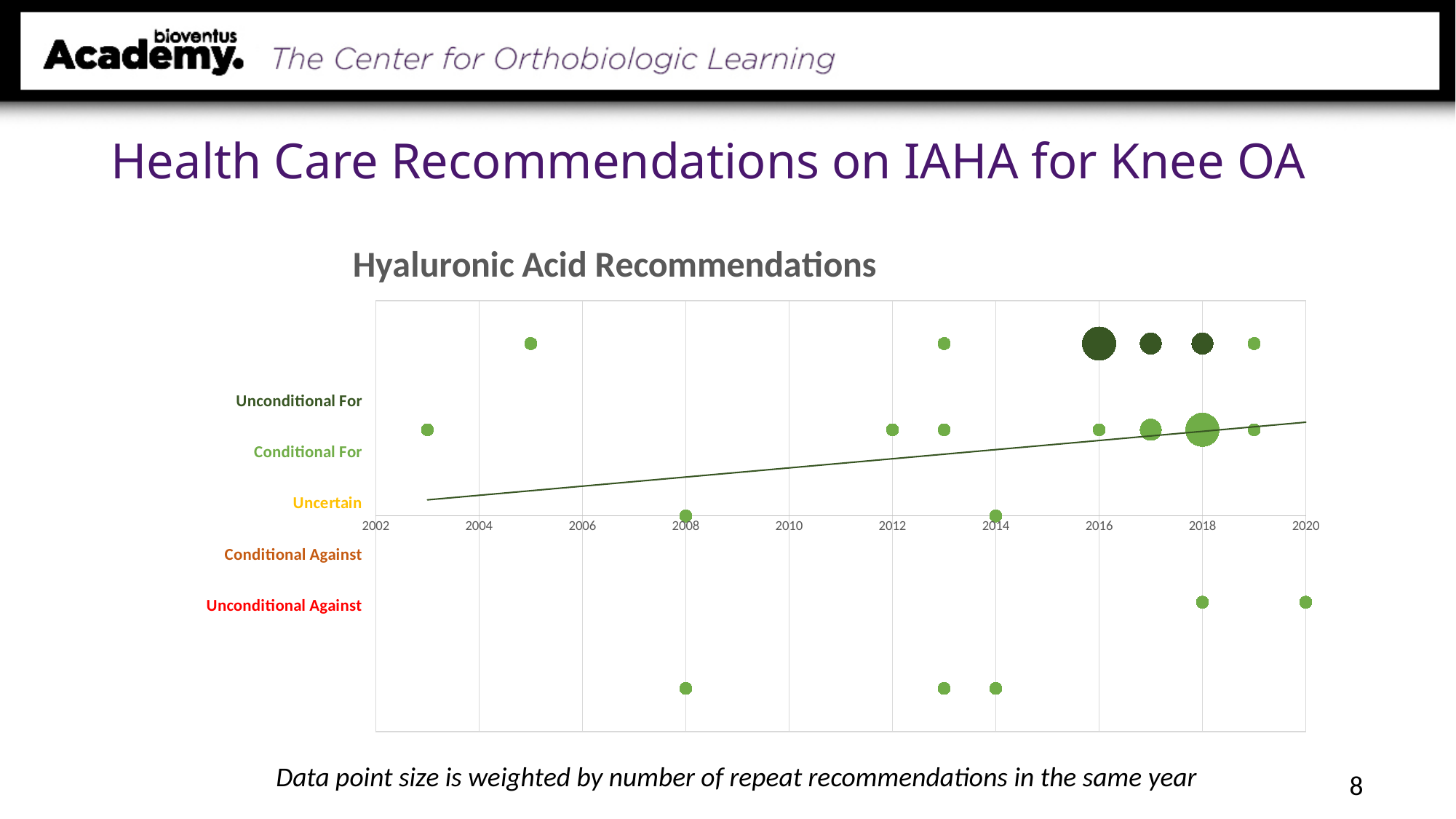
What is the first year shown on the x axis? 2002 What is the title of the chart? Hyaluronic Acid Recommendations According to the note below the chart, what is data point size weighted by? number of repeat recommendations in the same year What is the earliest year that has a data point plotted? 2003 What is the latest year that has a data point plotted? 2020 Does the trend line in the chart rise or fall from left to right? rise What is the last year shown on the x axis? 2020 How many year labels are shown on the x axis? 10 How many category labels are listed on the y axis? 5 What kind of chart is shown on the slide? bubble chart How many data points are plotted in the bottommost row of the chart? 3